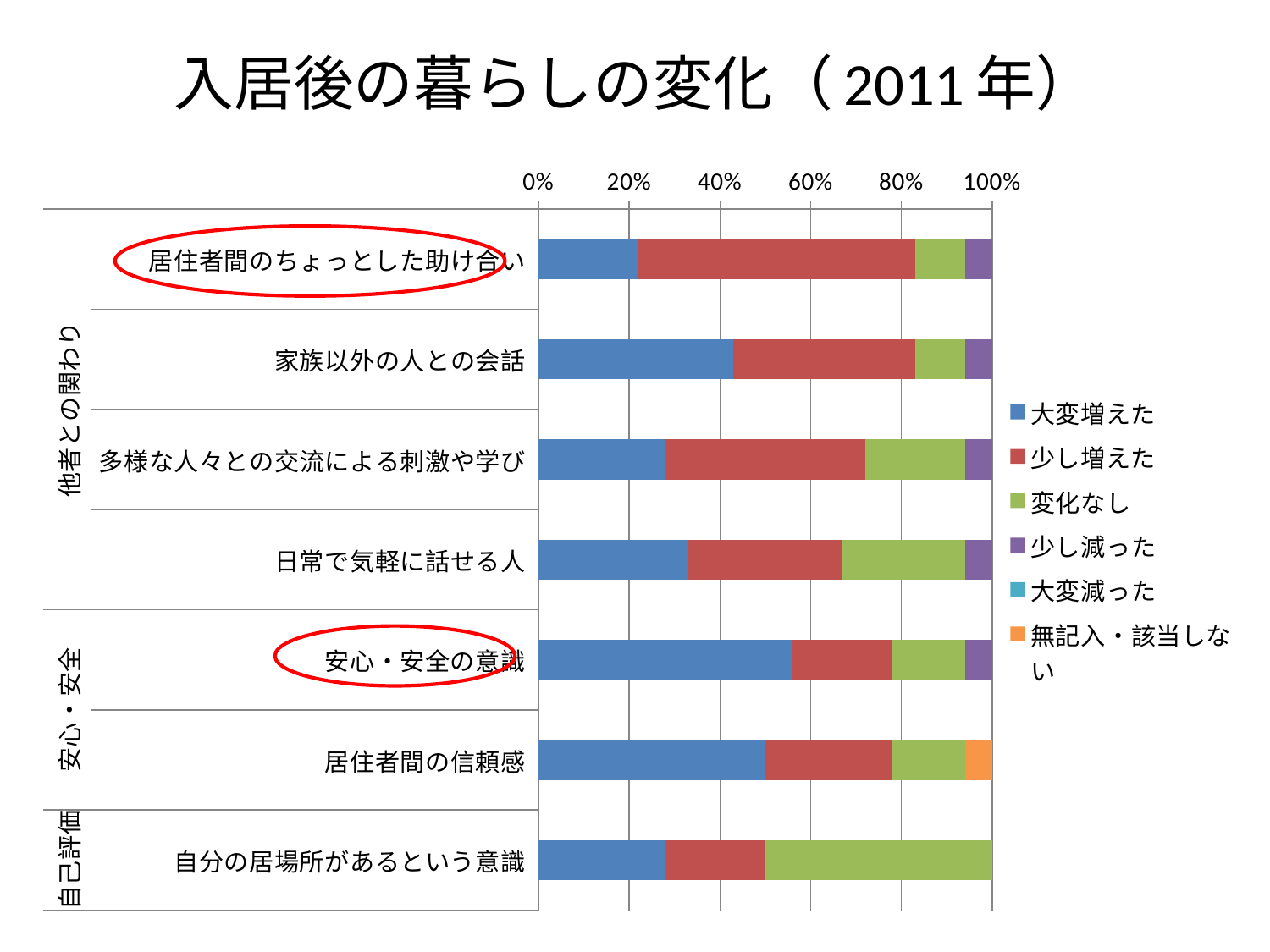
Is the 大変増えた value for 居住者間のちょっとした助け合い greater or less than 40%? less Is the 大変増えた value for 安心・安全の意識 greater or less than 40%? greater Which two categories are circled in red on the slide? 居住者間のちょっとした助け合い and 安心・安全の意識 Which category has a larger 少し増えた segment, 居住者間のちょっとした助け合い or 安心・安全の意識? 居住者間のちょっとした助け合い What is the title of the chart? 入居後の暮らしの変化（2011年） What kind of chart is shown on the slide? Stacked bar chart How many series does the legend list? 6 How many categories (rows) are plotted in the chart? 7 Which category has the largest 変化なし segment? 自分の居場所があるという意識 Which category has the largest 大変増えた segment? 安心・安全の意識 Which category is the only one with a 無記入・該当しない (orange) segment? 居住者間の信頼感 Which category has the smallest 大変増えた segment? 居住者間のちょっとした助け合い